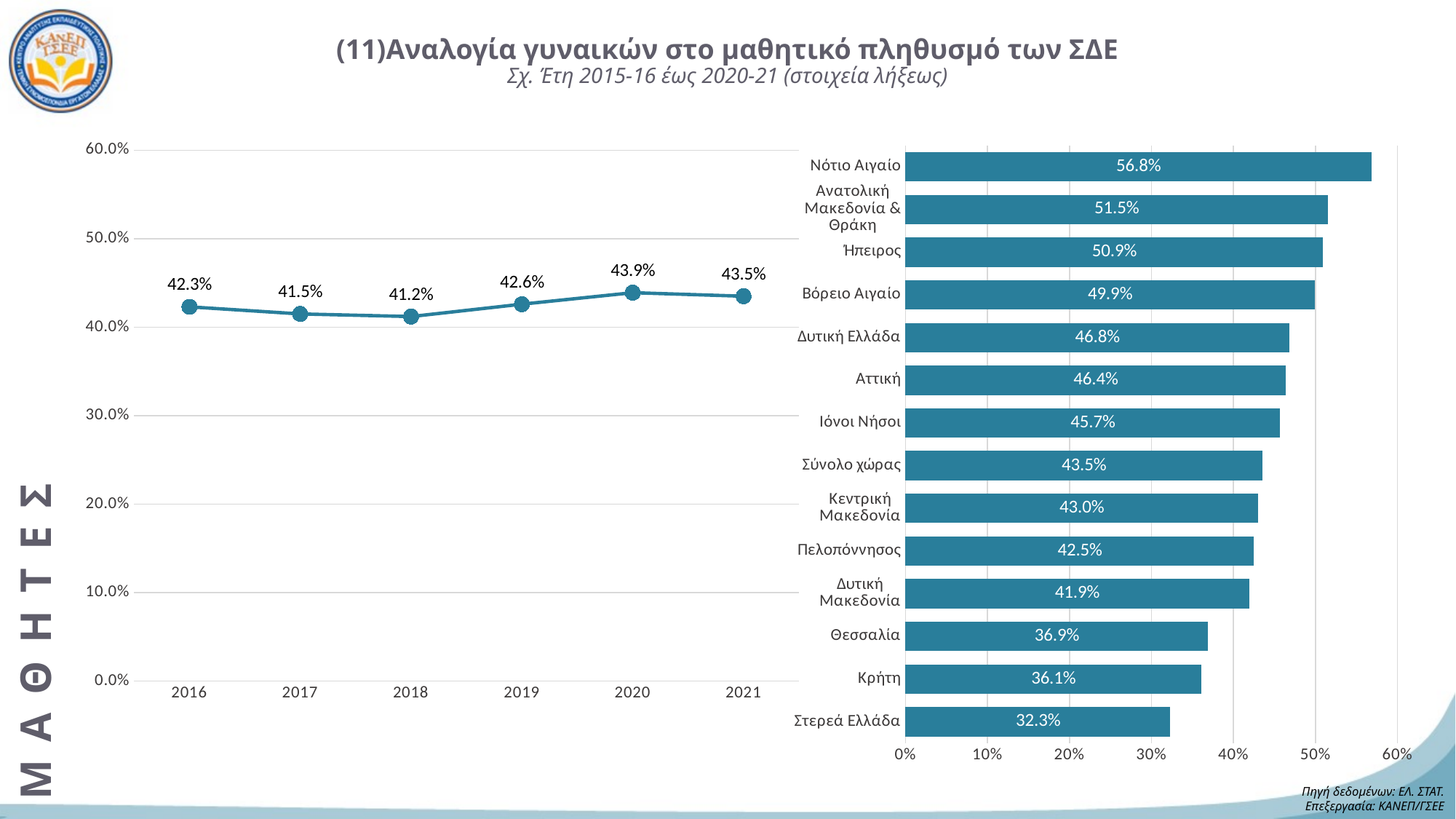
In the line chart on the left, which year has the highest value? 2020 In the line chart on the left, what is the value for 2018? 41.2% In the line chart on the left, what kind of chart is it? line chart In the bar chart on the right, how many bars are there? 14 In the bar chart on the right, which is larger, the value for Ήπειρος or the value for Θεσσαλία? Ήπειρος In the bar chart on the right, what is the value for Κρήτη? 36.1% In the bar chart on the right, what is the difference between the values for Νότιο Αιγαίο and Στερεά Ελλάδα? 24.5% In the bar chart on the right, which region has the highest value? Νότιο Αιγαίο In the line chart on the left, what is the difference between the 2020 value and the 2016 value? 1.6% In the line chart on the left, which year has the lowest value? 2018 In the bar chart on the right, which category has the lowest value? Στερεά Ελλάδα In the line chart on the left, how many data points are plotted? 6